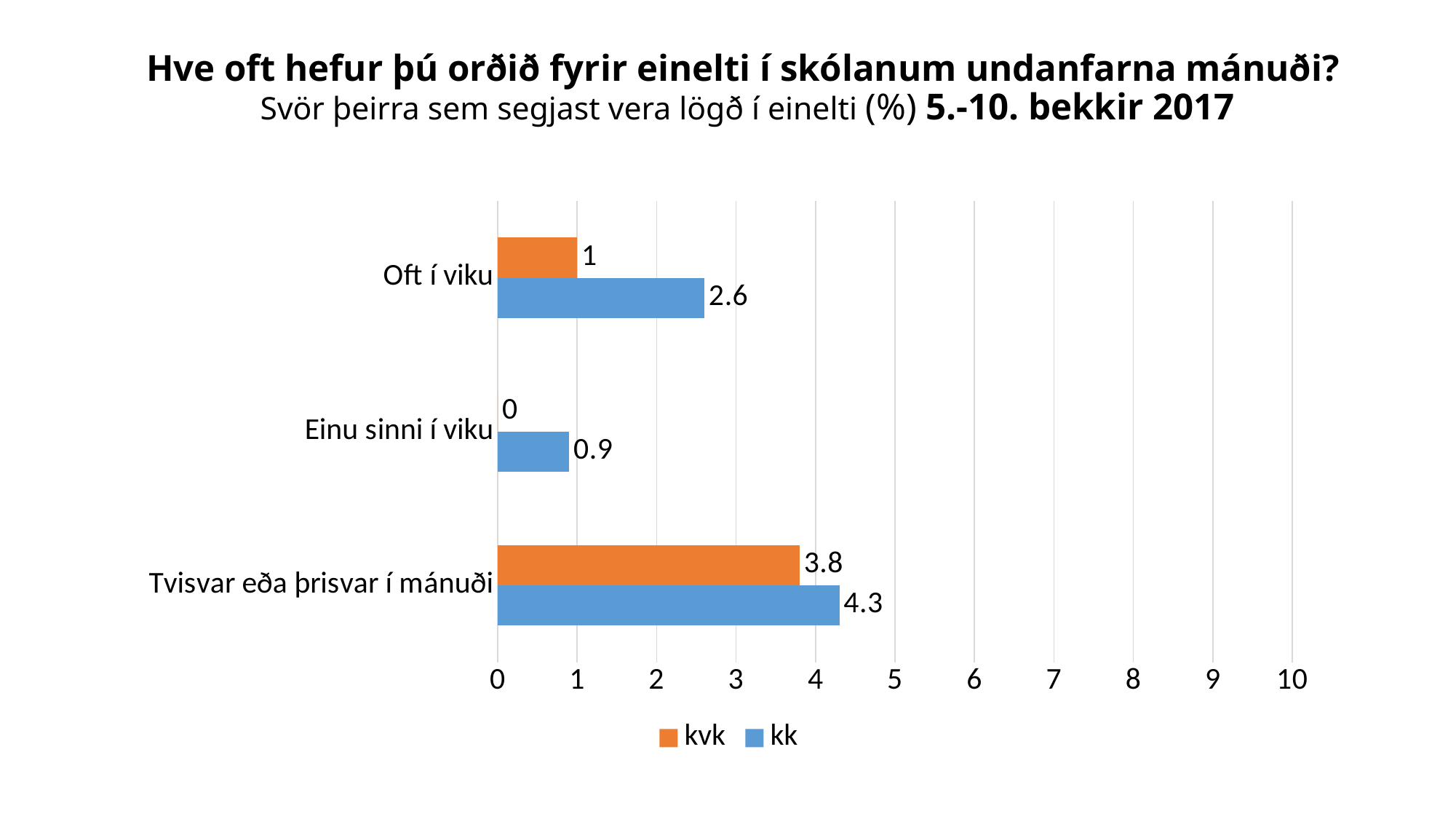
How many series does the legend list? 2 How many categories are shown on the chart? 3 What is the difference between the kk and kvk values in the 'Oft í viku' category? 1.6 Which colour represents the kvk series? Orange What is the value for kvk in the 'Einu sinni í viku' category? 0 Which category has the lowest value for kvk? Einu sinni í viku What is the value for kvk in the 'Tvisvar eða þrisvar í mánuði' category? 3.8 What is the value for kk in the 'Einu sinni í viku' category? 0.9 Which is larger in the 'Tvisvar eða þrisvar í mánuði' category, kvk or kk? kk What kind of chart is shown on the slide? Bar chart Which category has the highest value for kk? Tvisvar eða þrisvar í mánuði What is the value for kk in the 'Oft í viku' category? 2.6